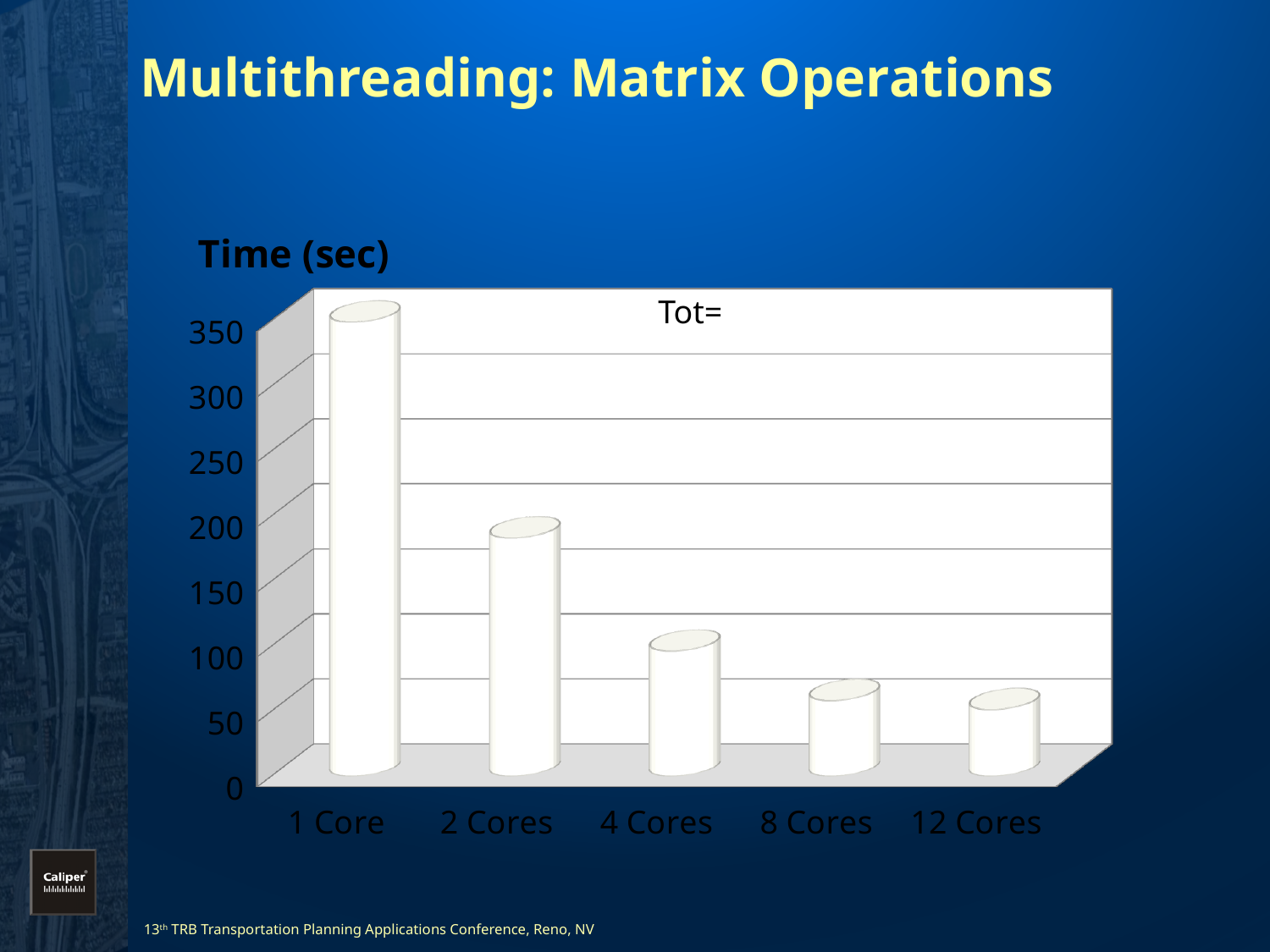
Is the value for 2 Cores greater or less than 150? greater Which is larger, the value for 2 Cores or the value for 4 Cores? 2 Cores Is the value for 12 Cores greater or less than 100? less Is the value for 8 Cores greater or less than 100? less What kind of chart is shown on the slide? bar chart Do the values rise or fall as the number of cores increases along the x axis? fall Which category has the lowest value? 12 Cores How many categories are plotted on the x axis? 5 Which category has the highest value? 1 Core What is the title of the chart? Time (sec)